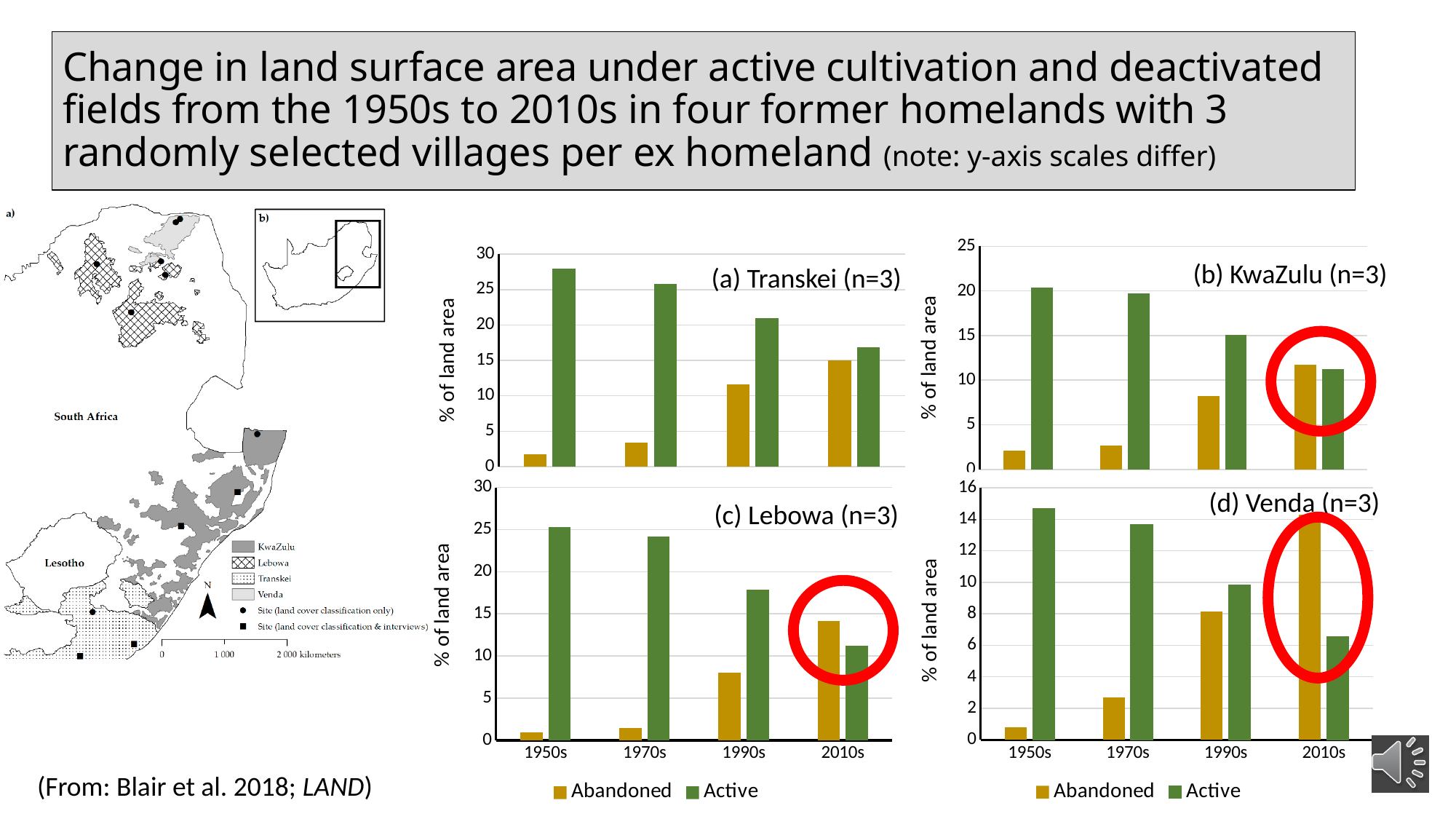
In the (d) Venda (n=3) chart, which is larger in the 2010s, Abandoned or Active? Abandoned In the (b) KwaZulu (n=3) chart, is the Abandoned value for the 1990s greater or less than 10? less In the (c) Lebowa (n=3) chart, which is larger in the 2010s, Abandoned or Active? Abandoned In the (a) Transkei (n=3) chart, which period has the lowest Abandoned value? 1950s How many time-period categories are shown on the x axis of the (a) Transkei (n=3) chart? 4 In the (c) Lebowa (n=3) chart, does the Active series rise or fall from the 1950s to the 2010s? fall What kind of chart is the (a) Transkei (n=3) chart? bar chart In the (a) Transkei (n=3) chart, is the Active value for the 1950s greater or less than 25? greater How many series does the legend list for the (c) Lebowa (n=3) chart? 2 What is the y-axis label on the (b) KwaZulu (n=3) chart? % of land area In the (d) Venda (n=3) chart, does the Abandoned series rise or fall from the 1950s to the 2010s? rise In the (a) Transkei (n=3) chart, which period has the highest Active value? 1950s